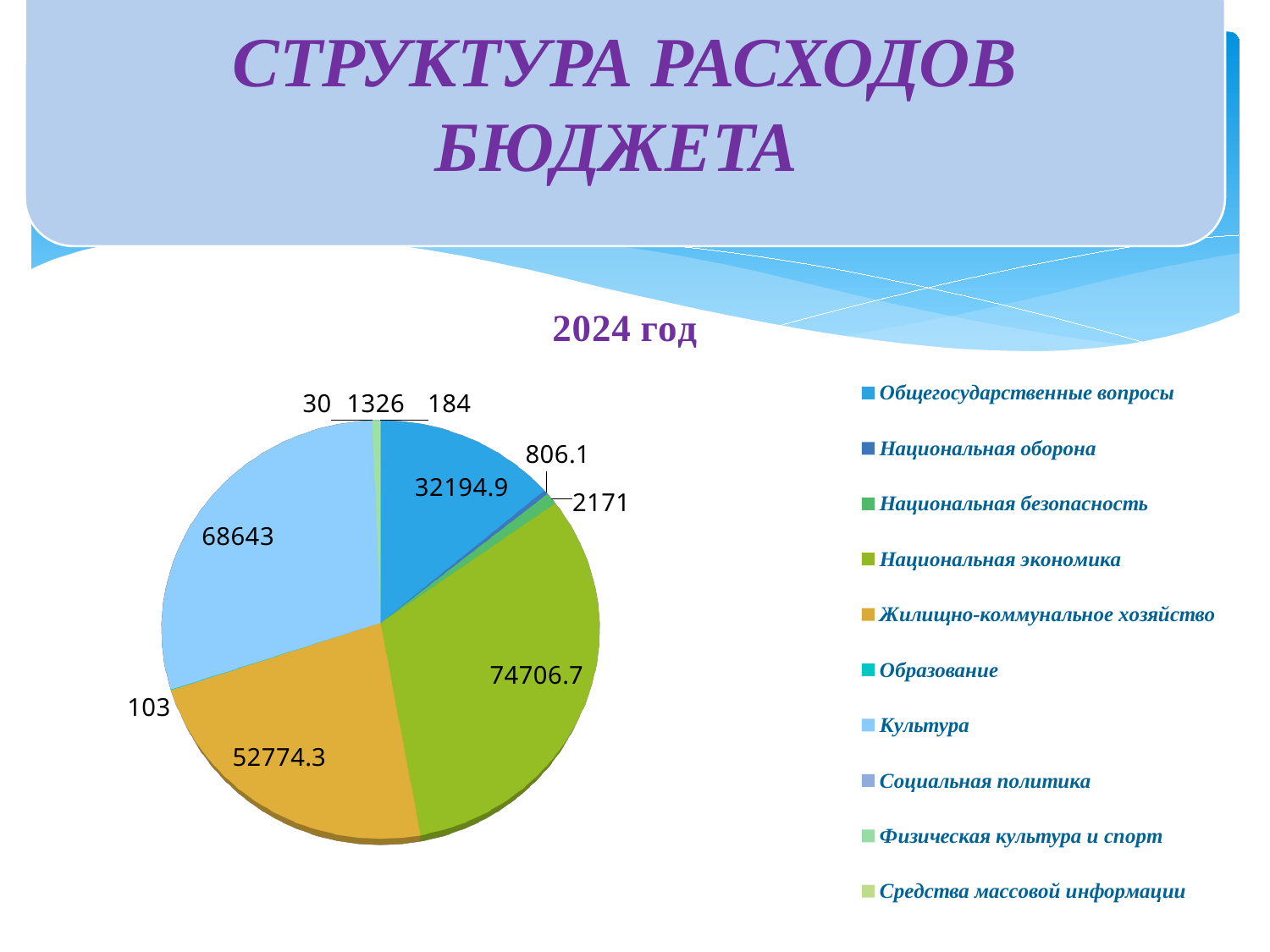
What is the value for Национальная экономика in the 2024 год pie chart? 74706.7 What is the value for Культура in the pie chart? 68643 What is the value for Жилищно-коммунальное хозяйство in the pie chart? 52774.3 How many categories does the legend of the pie chart list? 10 Which is larger in the pie chart, Культура or Жилищно-коммунальное хозяйство? Культура What is the difference between the values for Национальная экономика and Культура? 6063.7 What is the value for Общегосударственные вопросы in the pie chart? 32194.9 What kind of chart is shown on the slide? pie chart Which category has the largest slice in the pie chart? Национальная экономика What is the value for Национальная оборона in the pie chart? 806.1 What is the difference between the values for Культура and Жилищно-коммунальное хозяйство? 15868.7 What is the title shown above the pie chart? 2024 год